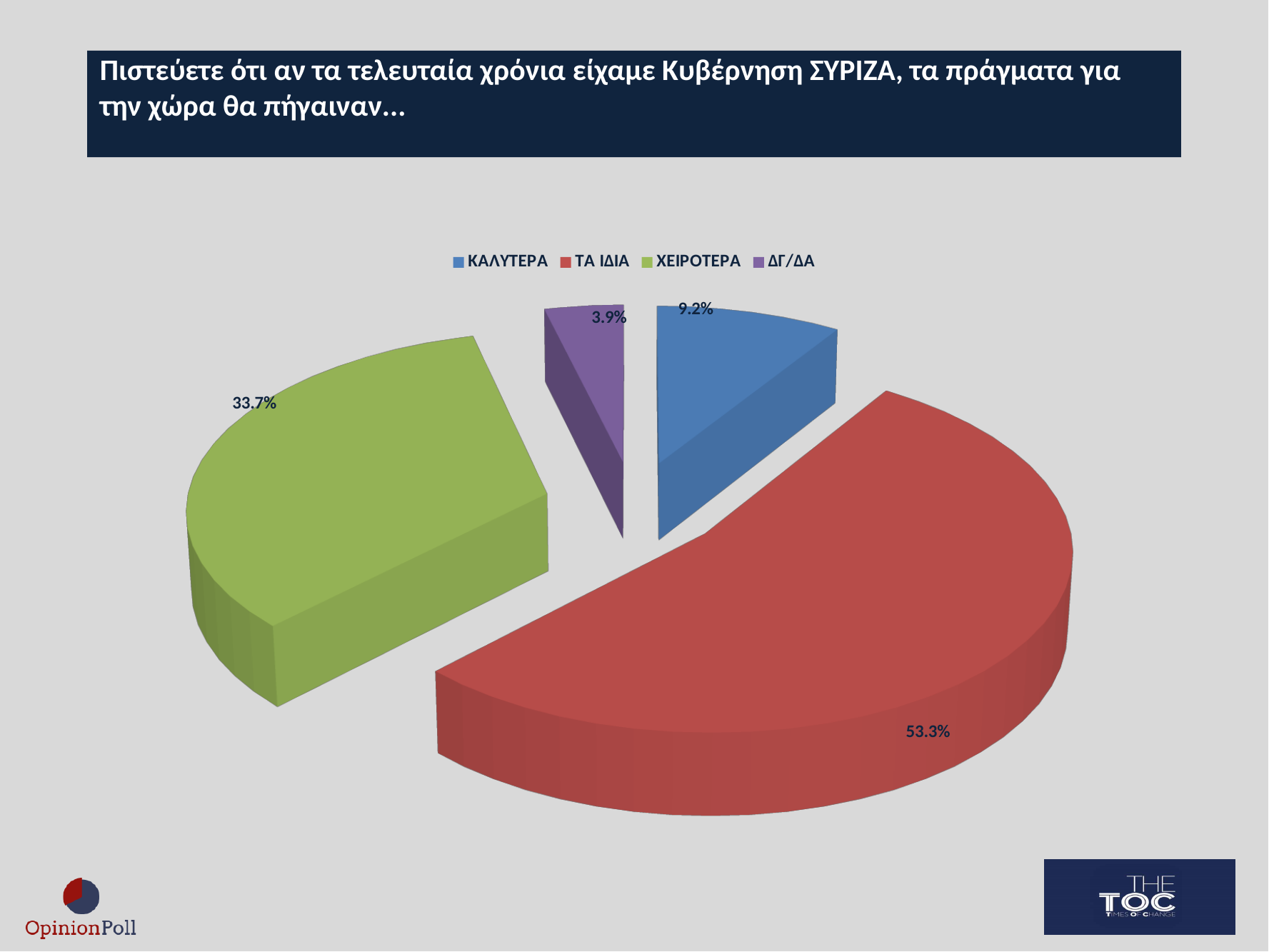
Which category has the largest slice of the pie? ΤΑ ΙΔΙΑ Which is larger, the share for ΚΑΛΥΤΕΡΑ or the share for ΔΓ/ΔΑ? ΚΑΛΥΤΕΡΑ What kind of chart is shown on the slide? Pie chart What colour is the slice for ΧΕΙΡΟΤΕΡΑ? Green Which category has the smallest slice of the pie? ΔΓ/ΔΑ What percentage is shown for ΤΑ ΙΔΙΑ? 53.3% What is the difference in percentage points between ΤΑ ΙΔΙΑ and ΧΕΙΡΟΤΕΡΑ? 19.6 What percentage is shown for ΔΓ/ΔΑ? 3.9% How many slices does the pie chart have? 4 How many entries does the legend list? 4 What percentage is shown for ΧΕΙΡΟΤΕΡΑ? 33.7% What percentage is shown for ΚΑΛΥΤΕΡΑ? 9.2%